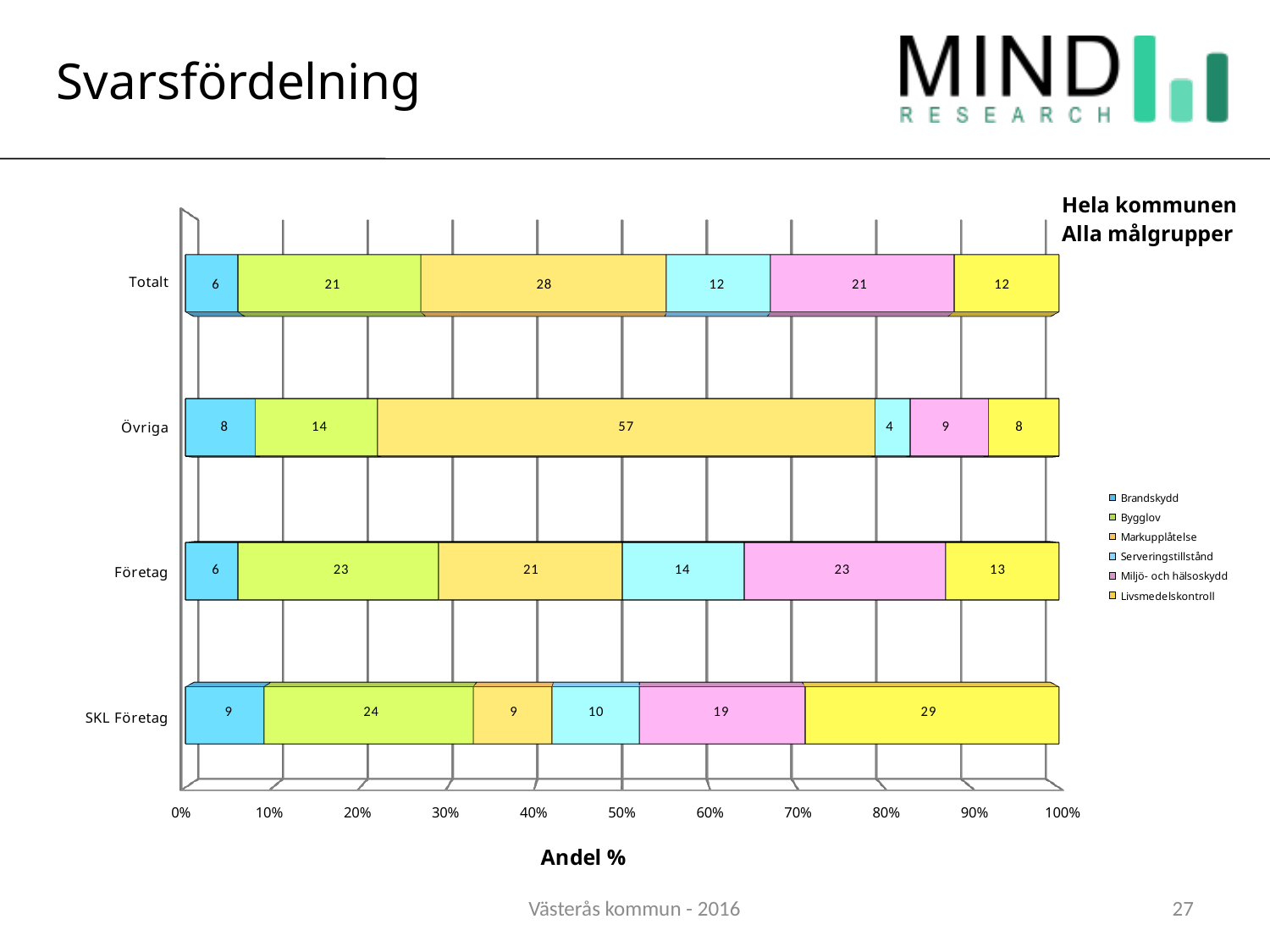
What is the difference between the Bygglov values for SKL Företag and Övriga? 10 What is the value for Brandskydd in the Totalt bar? 6 What is the value for Livsmedelskontroll in the SKL Företag bar? 29 Which is larger: Livsmedelskontroll for SKL Företag or Livsmedelskontroll for Företag? SKL Företag Which category has the highest value for Markupplåtelse? Övriga How many series does the legend list? 6 What kind of chart is shown on the slide? Stacked bar chart Which category has the lowest value for Serveringstillstånd? Övriga What is the label of the horizontal axis? Andel % What is the value for Markupplåtelse in the Övriga bar? 57 What is the value for Miljö- och hälsoskydd in the Företag bar? 23 How many categories are shown on the vertical axis? 4